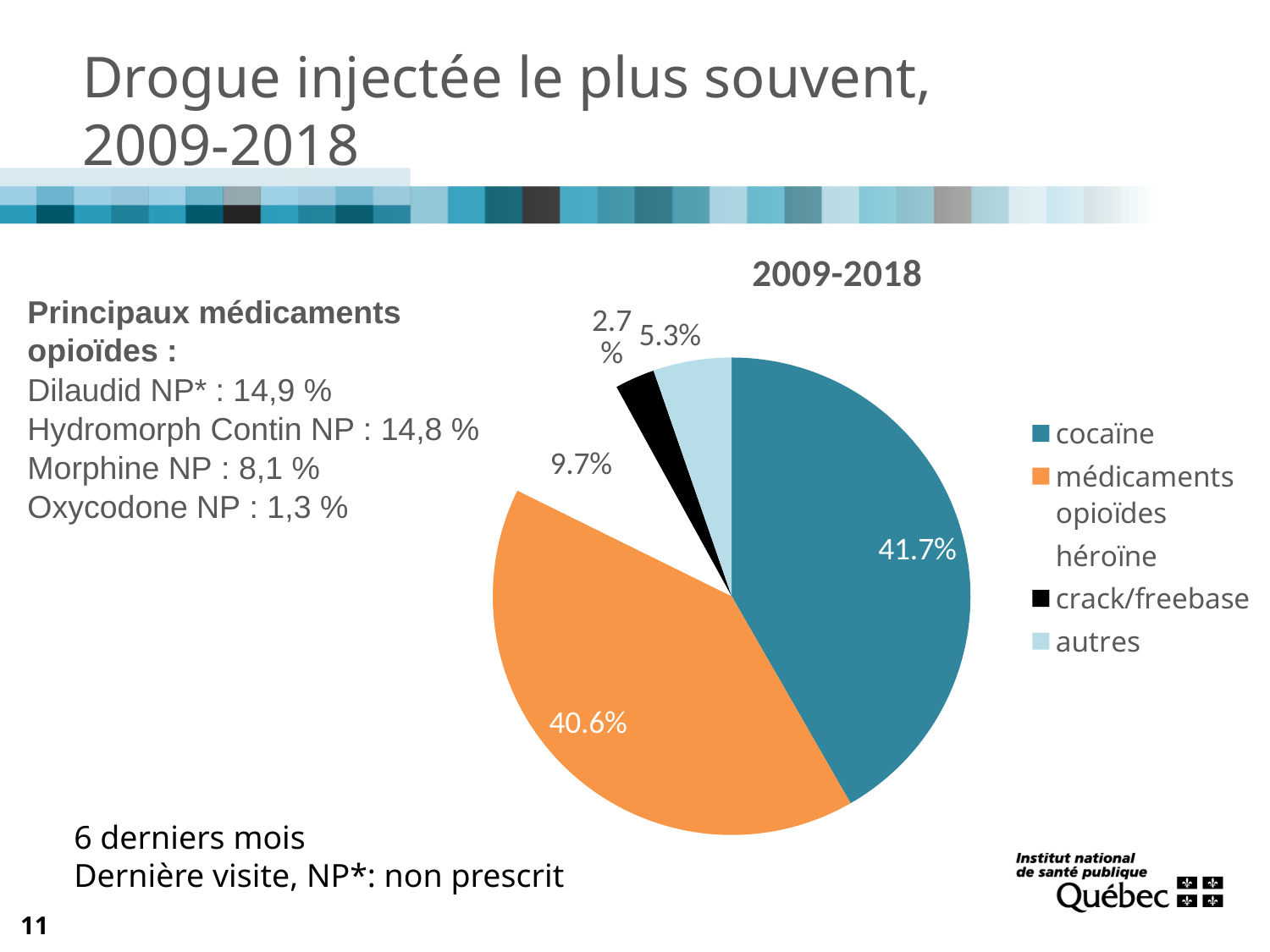
What percentage of the pie is crack/freebase? 2.7% What type of chart is shown on the slide? pie chart What is the title of the pie chart? 2009-2018 What percentage of the pie is médicaments opioïdes? 40.6% What percentage of the pie is héroïne? 9.7% What percentage of the pie is cocaïne? 41.7% What is the difference in percentage points between cocaïne and médicaments opioïdes? 1.1 Which category has the largest share of the pie? cocaïne What percentage of the pie is autres? 5.3% How many categories does the legend of the pie chart list? 5 Which category has the smallest share of the pie? crack/freebase Which is larger, the share for héroïne or the share for autres? héroïne